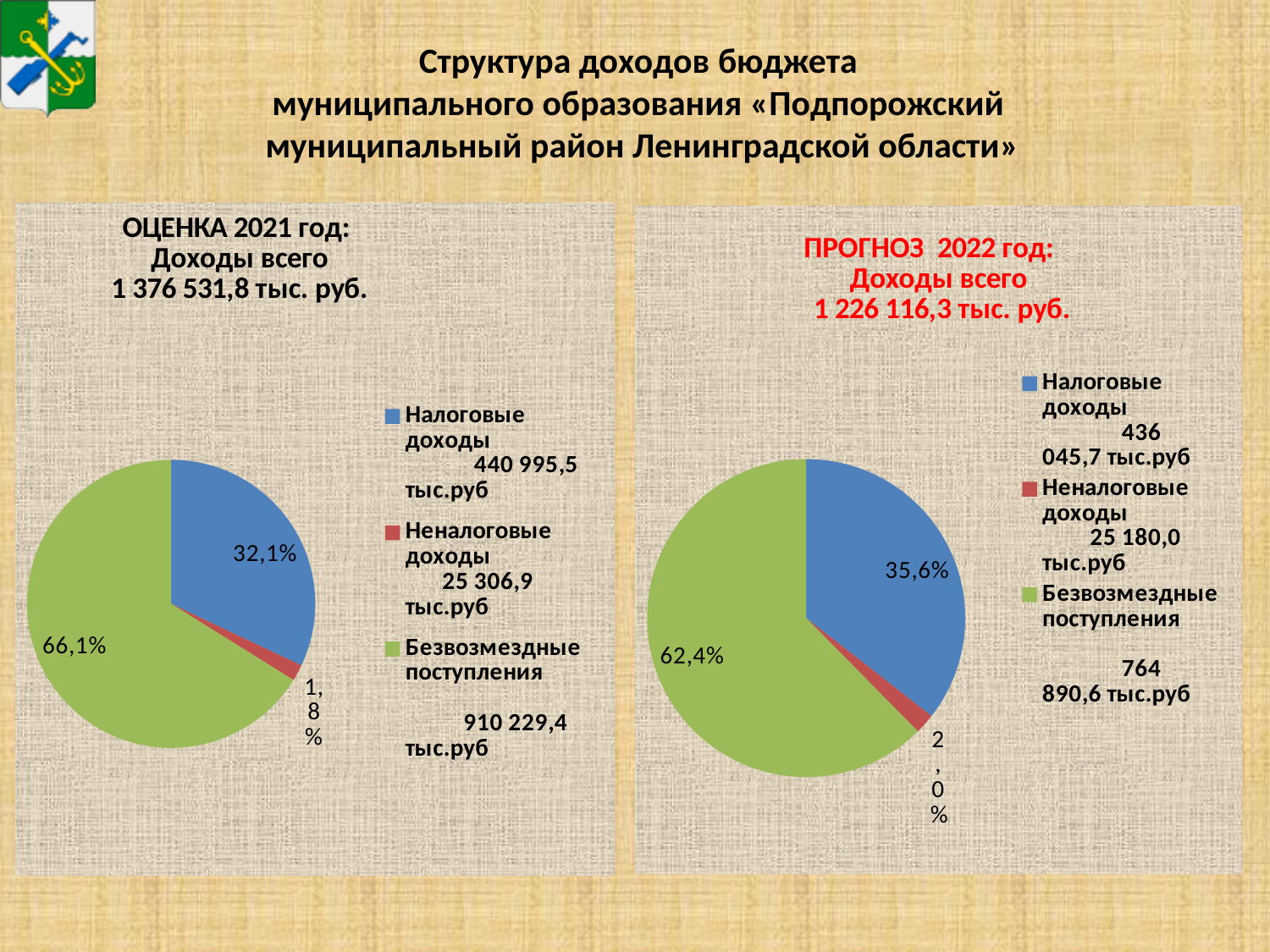
What is the difference in percentage points between the Безвозмездные поступления share in the left chart (66,1%) and in the right chart (62,4%)? 3,7 percentage points In the left pie chart (ОЦЕНКА 2021 год), which category has the smallest share? Неналоговые доходы What type of chart is used on the left side of the slide (ОЦЕНКА 2021 год)? Pie chart In the right pie chart (ПРОГНОЗ 2022 год), what percentage is shown for Налоговые доходы? 35,6% In the right pie chart (ПРОГНОЗ 2022 год), which category has the largest share? Безвозмездные поступления In the left pie chart (ОЦЕНКА 2021 год), what percentage is shown for Неналоговые доходы? 1,8% How many categories does the legend of the right pie chart (ПРОГНОЗ 2022 год) list? 3 In the left chart's legend (ОЦЕНКА 2021 год), what amount in тыс.руб is given for Налоговые доходы? 440 995,5 тыс.руб In the right pie chart (ПРОГНОЗ 2022 год), what percentage is shown for Безвозмездные поступления? 62,4% In the left pie chart (ОЦЕНКА 2021 год), what percentage is shown for Безвозмездные поступления? 66,1% In the left pie chart (ОЦЕНКА 2021 год), what percentage is shown for Налоговые доходы? 32,1% In the right chart's legend (ПРОГНОЗ 2022 год), what amount in тыс.руб is given for Безвозмездные поступления? 764 890,6 тыс.руб